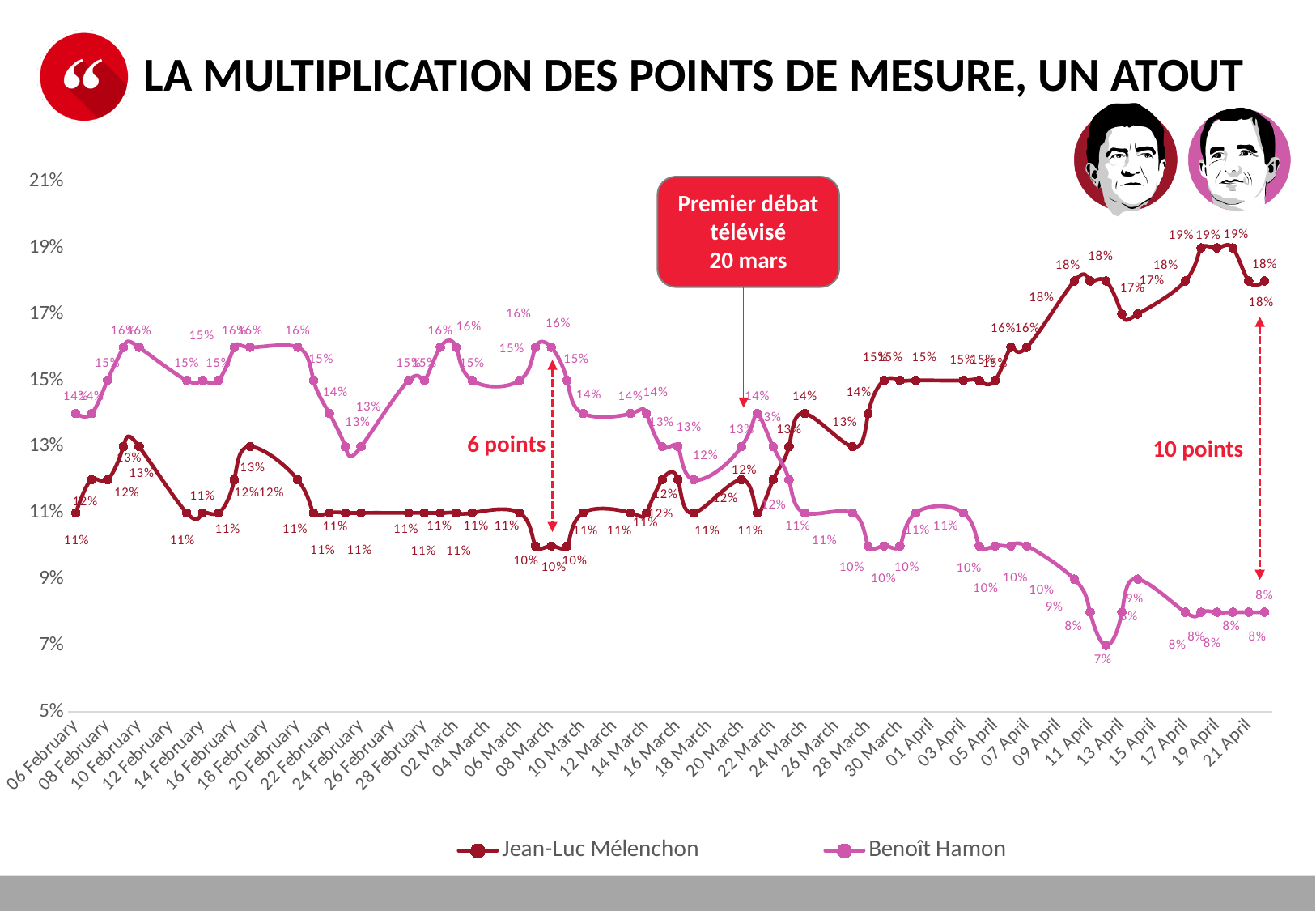
What is the value for Benoît Hamon on 21 April? 8% What is the value for Jean-Luc Mélenchon on 06 February? 11% What event does the annotation box on the chart mark, and on what date? Premier débat télévisé, 20 mars What is the lowest value reached by Benoît Hamon's line? 7% What is the value for Benoît Hamon on 06 February? 14% On 21 April, which candidate has the higher value, Jean-Luc Mélenchon or Benoît Hamon? Jean-Luc Mélenchon How many series does the legend list? 2 What is the highest value reached by Jean-Luc Mélenchon's line? 19% What kind of chart is shown on the slide? line chart What is the value for Jean-Luc Mélenchon on 21 April? 18% Which two candidates are listed in the legend? Jean-Luc Mélenchon and Benoît Hamon What is the difference between Jean-Luc Mélenchon's and Benoît Hamon's values on 21 April? 10 points